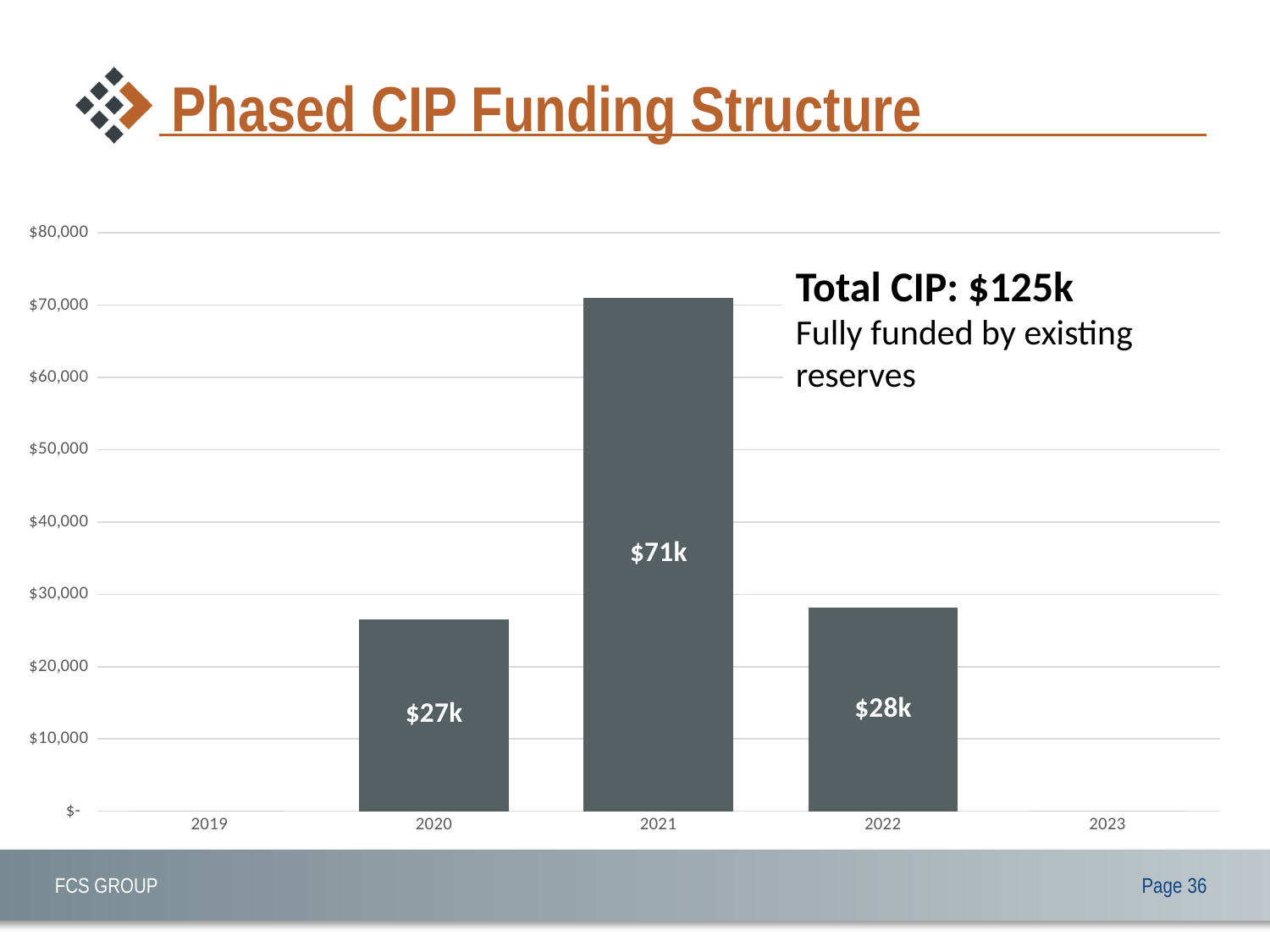
What is the value for 2021? $71k How many years are shown on the x axis? 5 What is the value for 2020? $27k Which year has the highest value? 2021 How many bars are plotted on the chart? 3 What is the title of the slide containing the chart? Phased CIP Funding Structure Is the value for 2021 greater or less than $60,000? greater What is the value for 2022? $28k Which year with a bar has the lowest value? 2020 What kind of chart is shown on the slide? bar chart Which is larger, the value for 2021 or the value for 2022? 2021 What is the difference between the values for 2021 and 2020? $44k